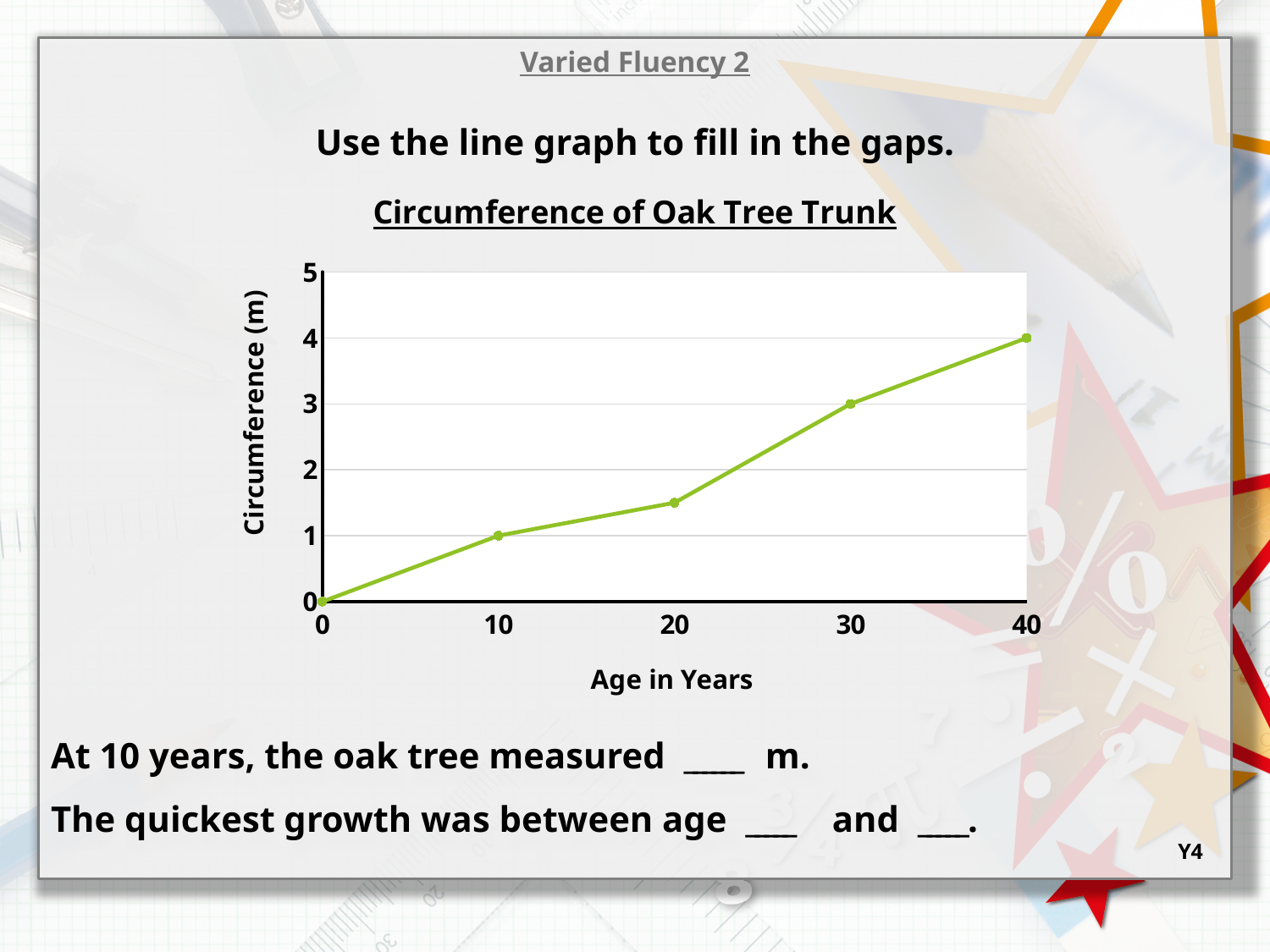
What is the title of the x axis? Age in Years Which has the larger circumference, age 30 or age 10? 30 At which age is the circumference of the oak tree trunk highest? 40 What is the circumference of the oak tree trunk at 10 years? 1 Is the circumference at 20 years greater or less than 2? less What is the circumference of the oak tree trunk at 30 years? 3 How many data points are plotted on the line graph? 5 What kind of chart is shown on the slide? line chart At which age is the circumference of the oak tree trunk lowest? 0 Does the circumference rise or fall as age increases? rise What is the difference in circumference between age 40 and age 10? 3 What is the circumference of the oak tree trunk at 40 years? 4